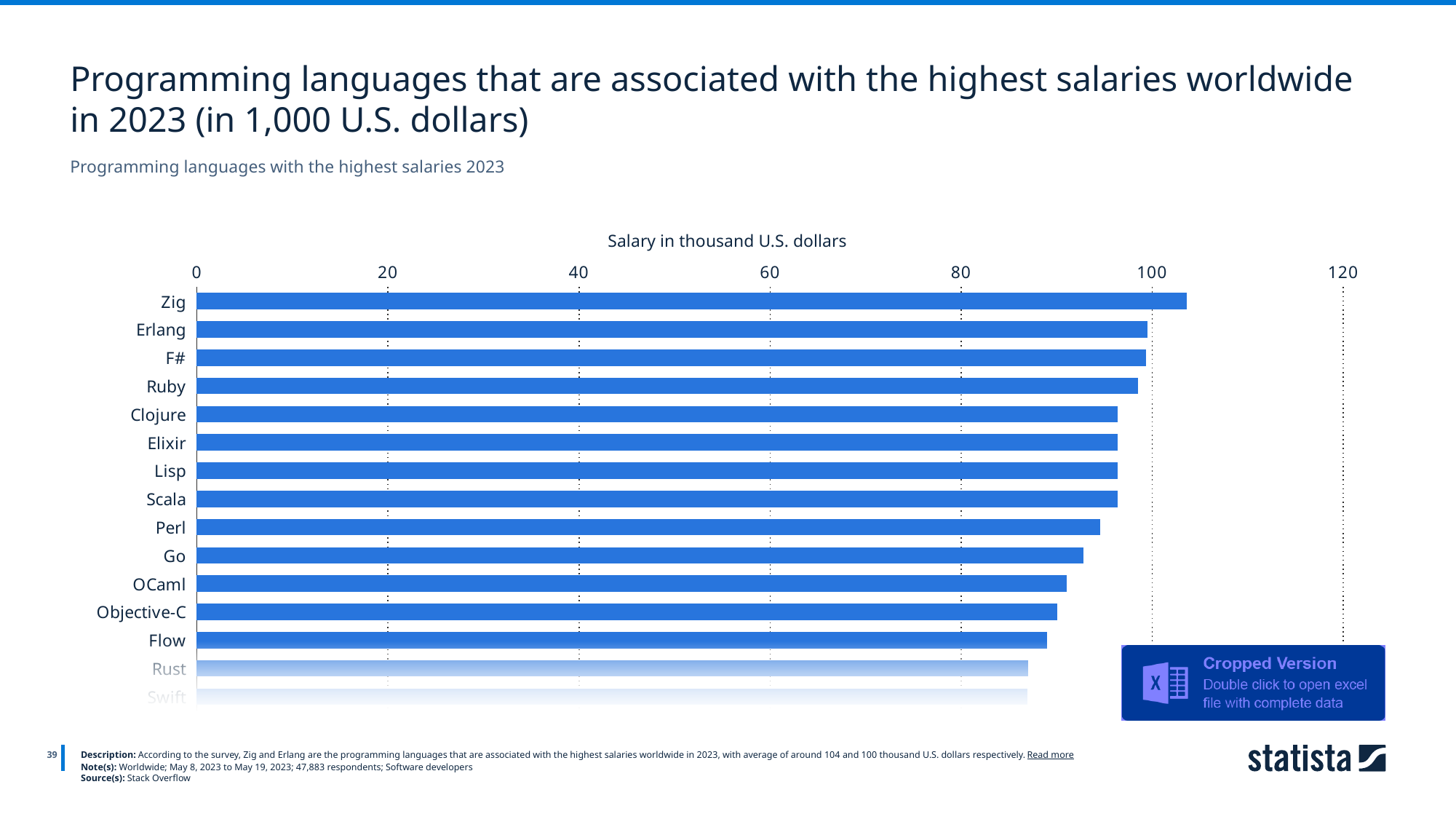
Which programming language has the highest salary in the chart? Zig What is the title of the horizontal axis of the chart? Salary in thousand U.S. dollars What kind of chart is shown on the slide? bar chart Do the bar values rise or fall going from the top of the chart to the bottom? fall Is the value for Clojure greater or less than 100? less Which has a higher salary, Erlang or Go? Erlang Is the value for Flow greater or less than 100? less Is the value for Objective-C greater or less than 100? less Which has a higher salary, Zig or Flow? Zig Which has a higher salary, Ruby or Objective-C? Ruby